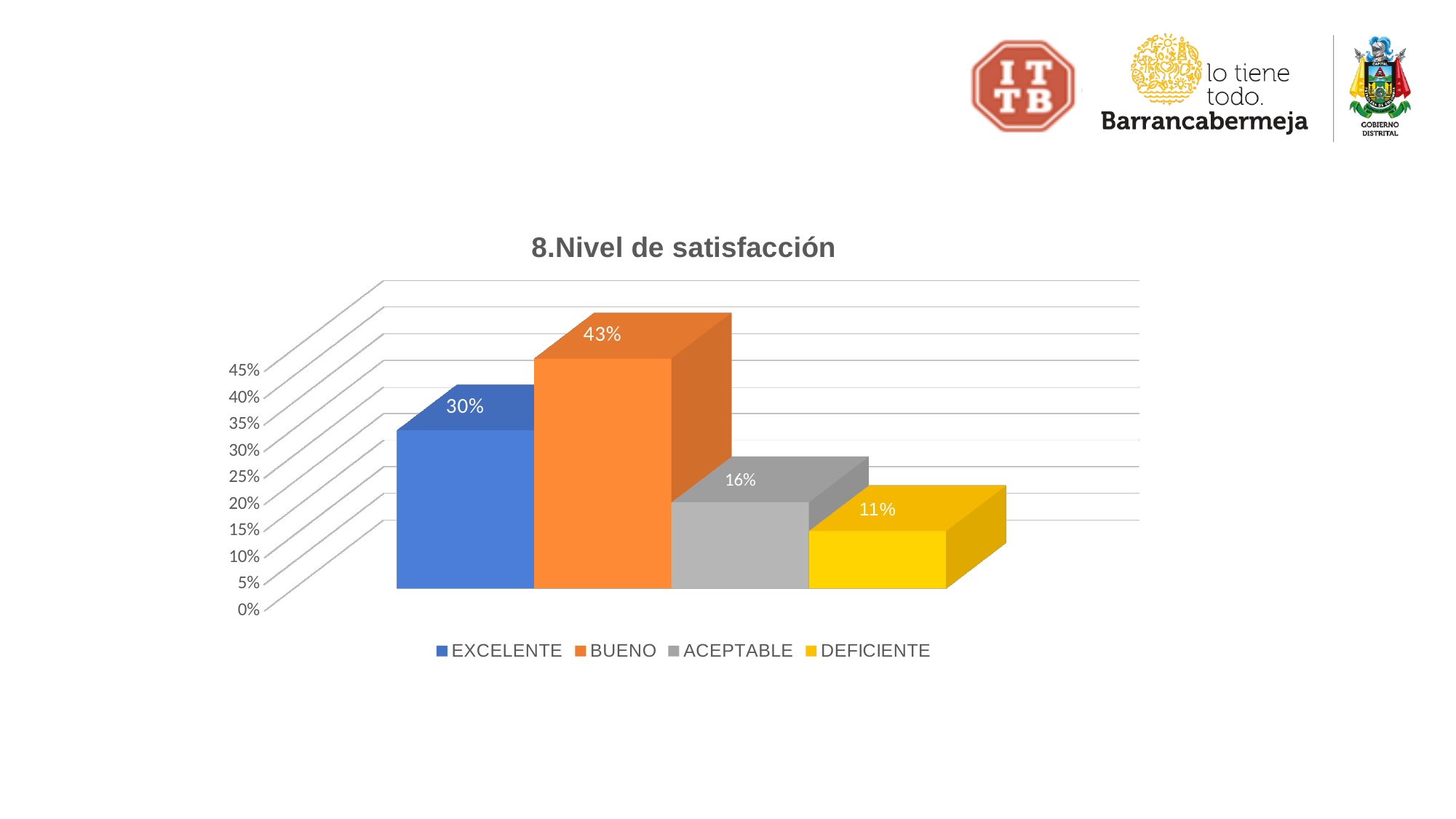
Which category has the lowest value? DEFICIENTE What is the title of the chart? 8.Nivel de satisfacción Which category has the highest value? BUENO What is the difference between the values for BUENO and EXCELENTE? 13% What is the value for ACEPTABLE? 16% What is the value for EXCELENTE? 30% Which is larger, the value for EXCELENTE or the value for ACEPTABLE? EXCELENTE What is the value for BUENO? 43% What is the value for DEFICIENTE? 11% How many categories are shown in the chart? 4 What is the difference between the values for ACEPTABLE and DEFICIENTE? 5% What kind of chart is shown on the slide? bar chart